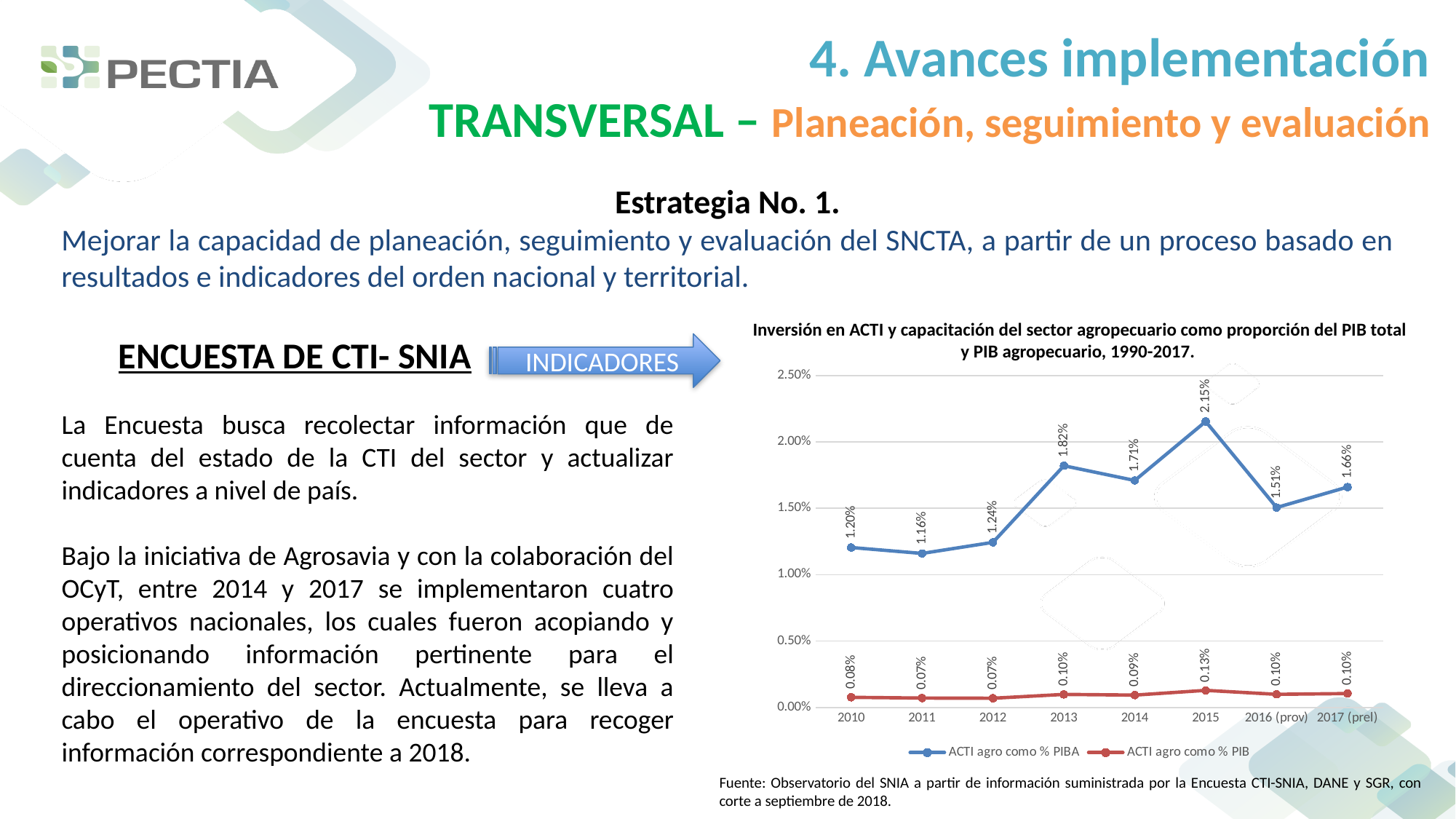
What is the value of ACTI agro como % PIBA in 2013? 1.82% In which year is ACTI agro como % PIBA highest? 2015 What is the value of ACTI agro como % PIB in 2015? 0.13% What is the difference between ACTI agro como % PIBA in 2015 and in 2016 (prov)? 0.64% Does ACTI agro como % PIBA rise or fall from 2012 to 2013? Rise Is the value of ACTI agro como % PIBA in 2015 greater or less than 2.00%? greater What type of chart is shown on the slide? Line chart Which is larger: ACTI agro como % PIBA in 2014 or in 2017 (prel)? 2014 How many years (data points) are plotted along the x axis of the chart? 8 How many series does the chart legend list? 2 Which series is drawn in red on the chart? ACTI agro como % PIB In which year is ACTI agro como % PIBA lowest? 2011